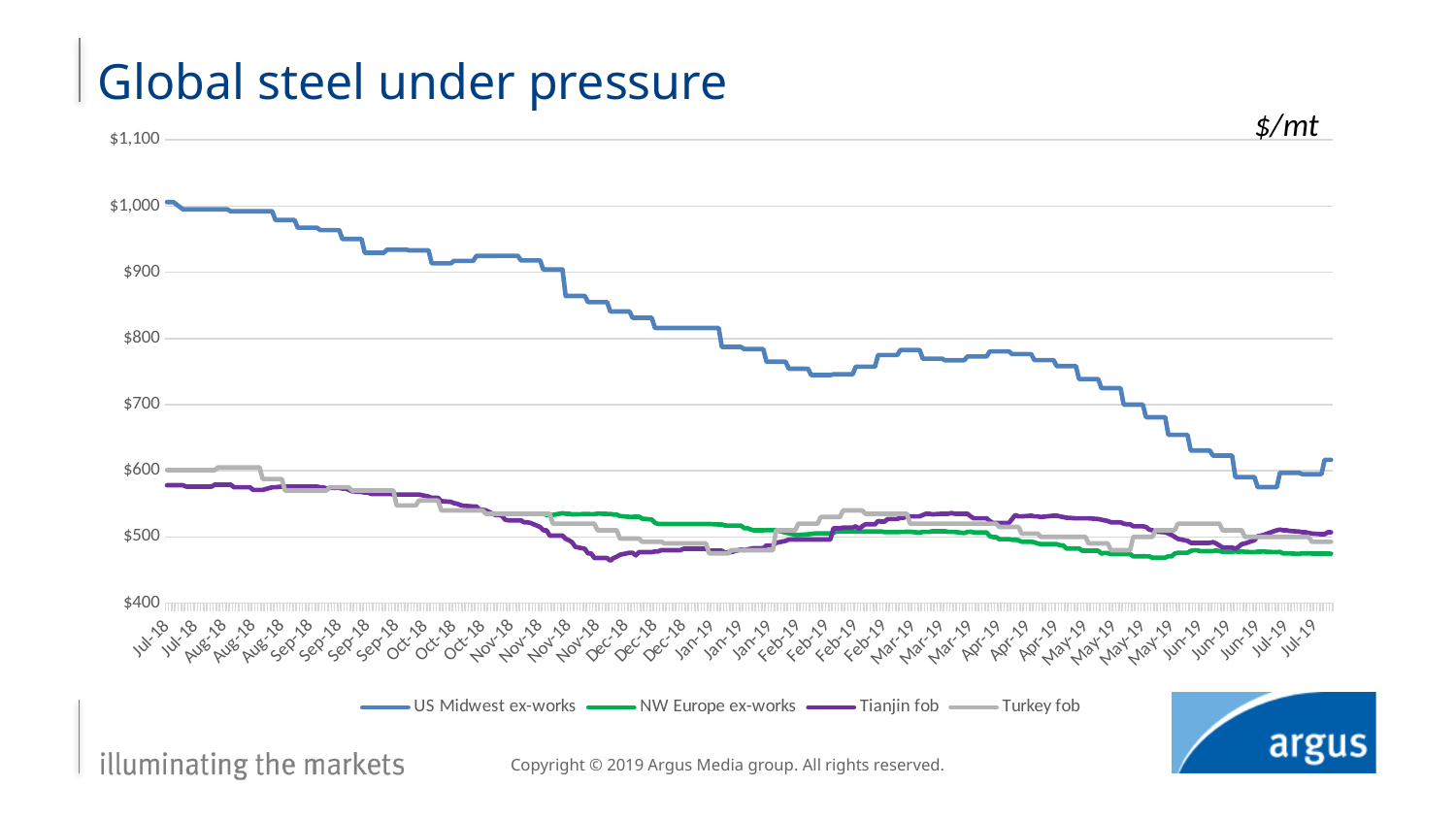
Does the NW Europe ex-works series rise or fall from Nov-18 to Jul-19? fall At the end of the period (Jul-19), which is higher: Tianjin fob or NW Europe ex-works? Tianjin fob What unit is shown for the values on the chart? $/mt Does the US Midwest ex-works series rise or fall from Jul-18 to Jul-19? fall Is the value for US Midwest ex-works in Jul-18 greater or less than $900? greater What is the title of the chart? Global steel under pressure Is the value for NW Europe ex-works in Jul-19 greater or less than $500? less Which series has the highest values across the whole period? US Midwest ex-works What kind of chart is shown on the slide? line chart Is the value for US Midwest ex-works in Apr-19 greater or less than $700? greater How many series does the legend list? 4